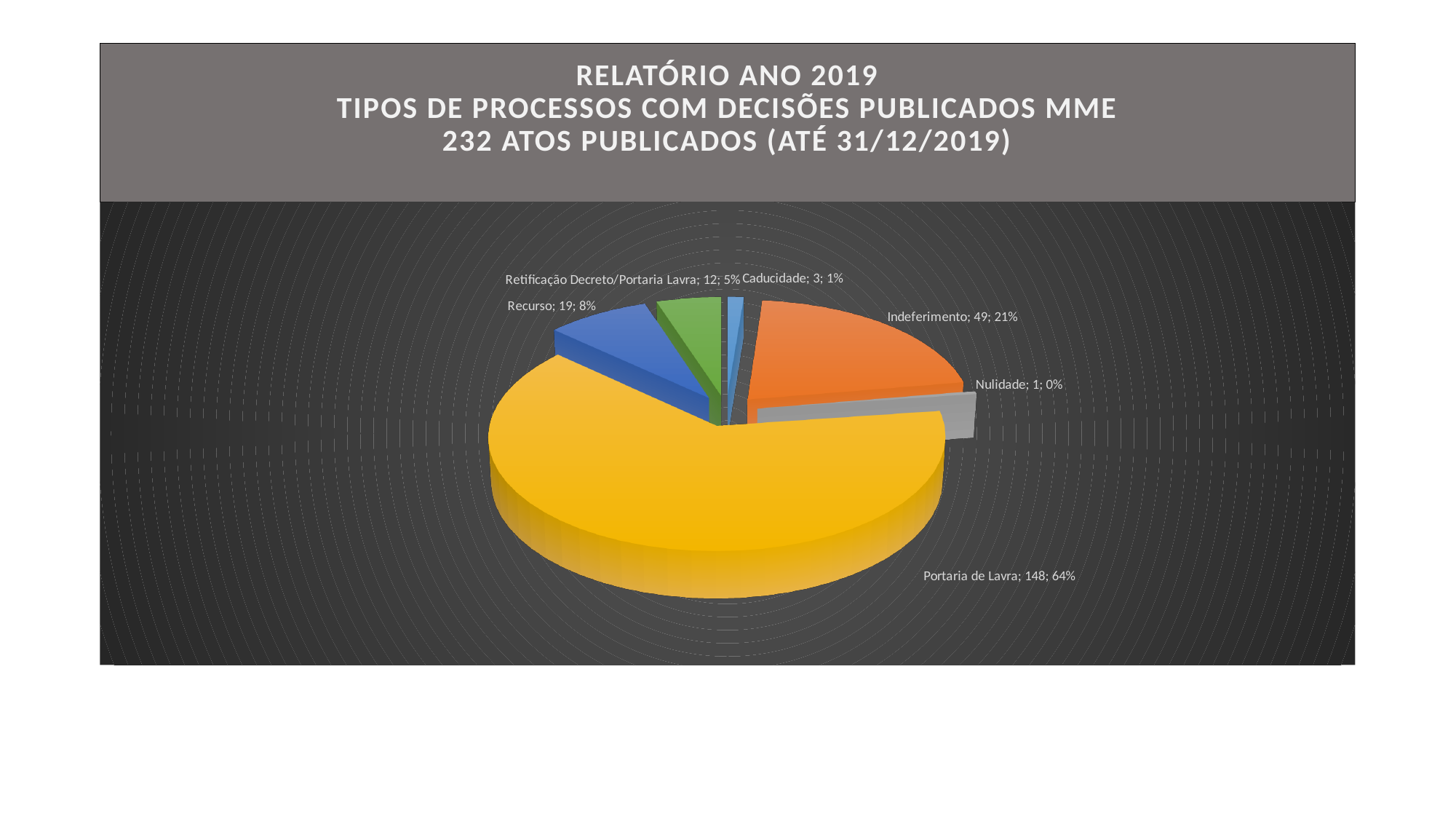
What is the value for Recurso? 19 What is the value for Portaria de Lavra? 148 How many slices does the pie chart have? 6 What share of the pie does Recurso represent? 8% Which category has the largest slice? Portaria de Lavra What is the value for Retificação Decreto/Portaria Lavra? 12 What is the difference between the values for Portaria de Lavra and Indeferimento? 99 What is the value for Indeferimento? 49 Which category has the smallest slice? Nulidade What share of the pie does Indeferimento represent? 21% Which is larger, the value for Caducidade or the value for Retificação Decreto/Portaria Lavra? Retificação Decreto/Portaria Lavra What kind of chart is shown on the slide? Pie chart